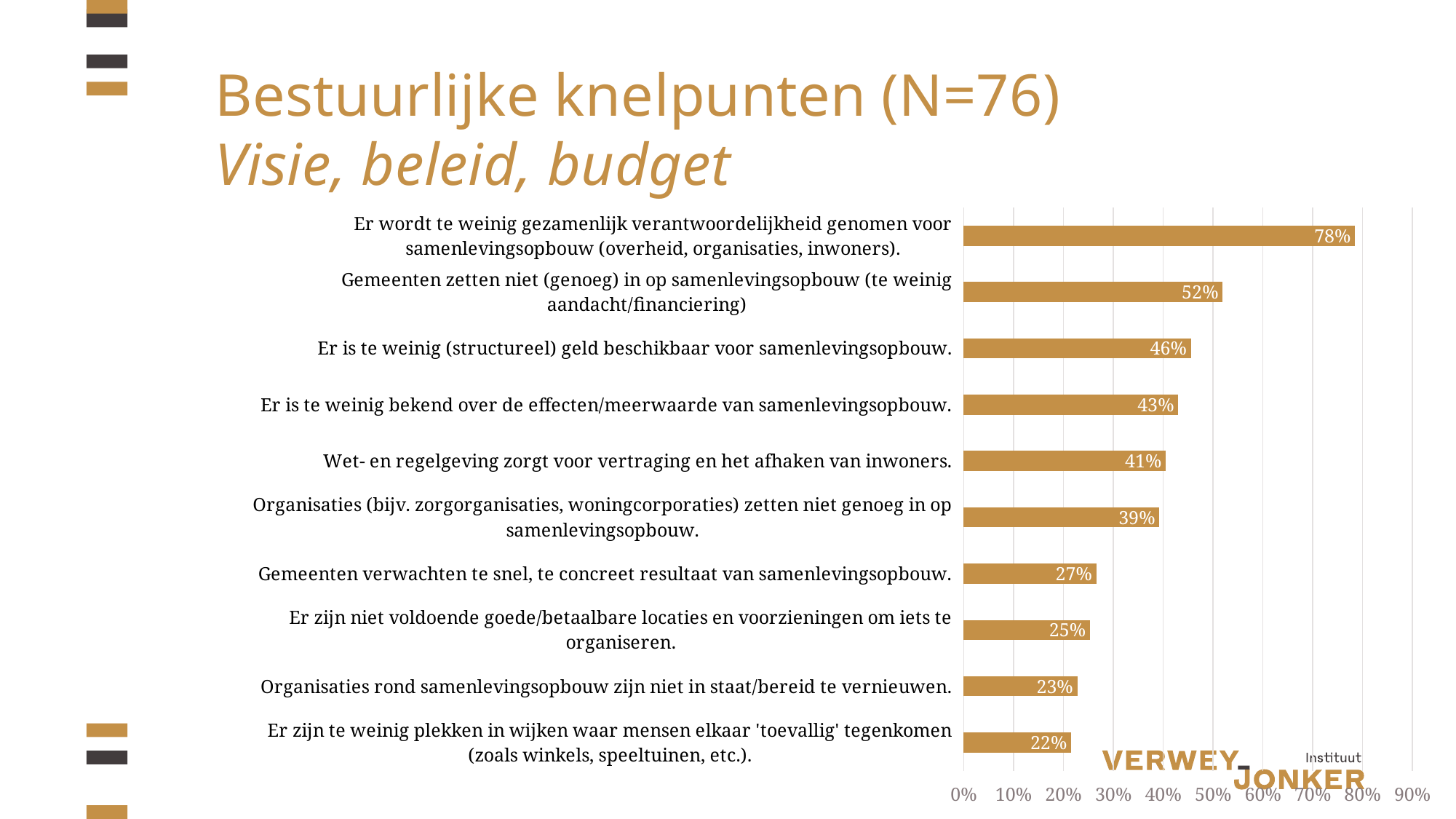
What is the difference between the value for 'Gemeenten zetten niet (genoeg) in op samenlevingsopbouw (te weinig aandacht/financiering)' and the value for 'Er is te weinig bekend over de effecten/meerwaarde van samenlevingsopbouw.'? 9% Which category has the lowest value? Er zijn te weinig plekken in wijken waar mensen elkaar 'toevallig' tegenkomen (zoals winkels, speeltuinen, etc.). How many categories are plotted in the chart? 10 Which is larger: the value for 'Wet- en regelgeving zorgt voor vertraging en het afhaken van inwoners.' or the value for 'Organisaties (bijv. zorgorganisaties, woningcorporaties) zetten niet genoeg in op samenlevingsopbouw.'? Wet- en regelgeving zorgt voor vertraging en het afhaken van inwoners. What is the highest value shown on the horizontal axis of the chart? 90% Is the value for 'Er zijn niet voldoende goede/betaalbare locaties en voorzieningen om iets te organiseren.' greater or less than 30%? less Which category has the highest value? Er wordt te weinig gezamenlijk verantwoordelijkheid genomen voor samenlevingsopbouw (overheid, organisaties, inwoners). What percentage is shown for 'Er wordt te weinig gezamenlijk verantwoordelijkheid genomen voor samenlevingsopbouw (overheid, organisaties, inwoners).'? 78% What is the value shown for 'Organisaties rond samenlevingsopbouw zijn niet in staat/bereid te vernieuwen.'? 23% What kind of chart is shown on the slide? Bar chart What value is shown for 'Er is te weinig (structureel) geld beschikbaar voor samenlevingsopbouw.'? 46% What percentage is shown for 'Gemeenten verwachten te snel, te concreet resultaat van samenlevingsopbouw.'? 27%